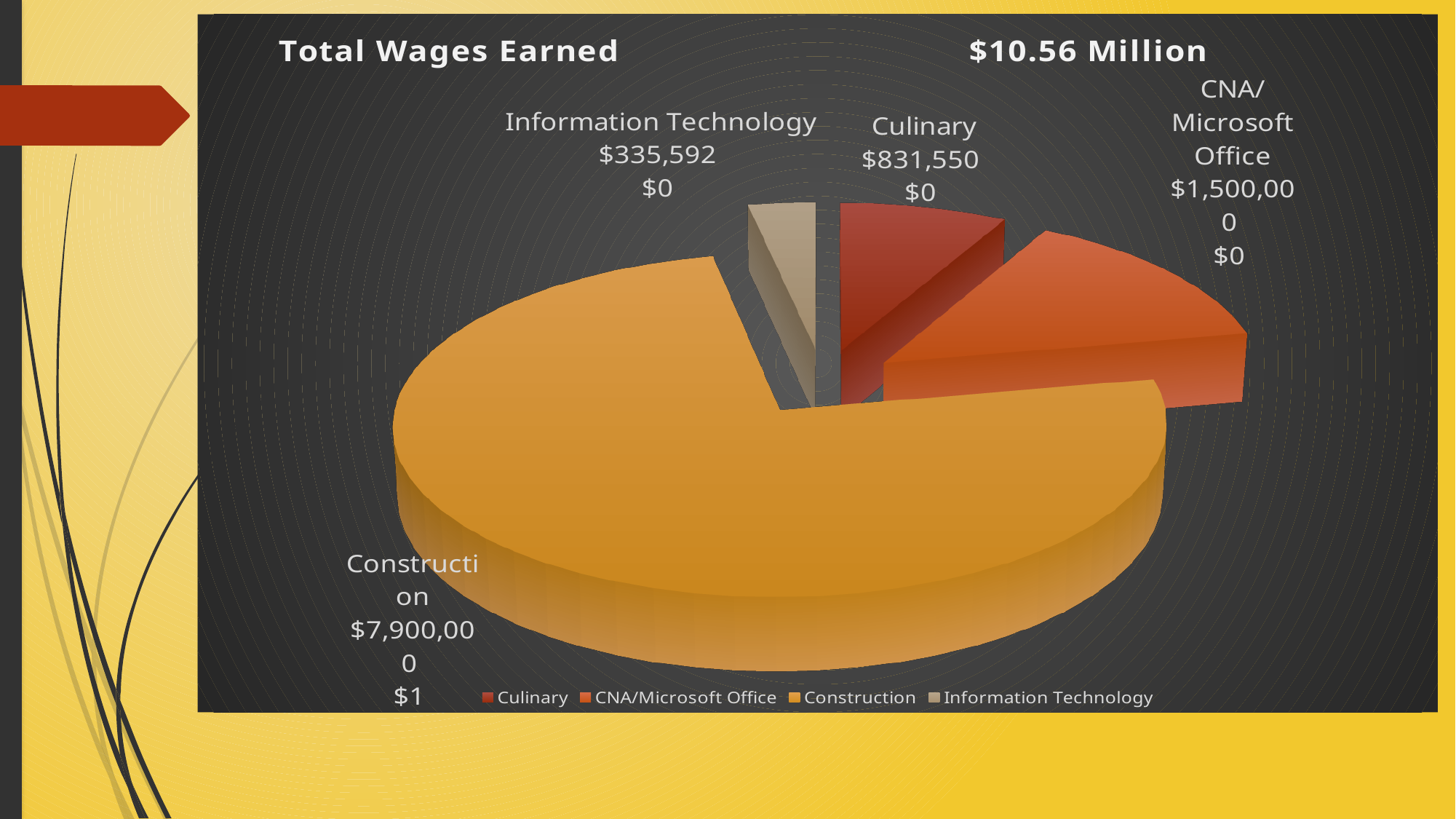
What is the value shown for Information Technology? $335,592 Which category has the smallest slice of the pie? Information Technology What is the value shown for Culinary? $831,550 What kind of chart is shown on the slide? Pie chart How many entries does the legend list? 4 What is the difference between the Construction value and the CNA/Microsoft Office value? $6,400,000 Which category has the largest slice of the pie? Construction What is the title of the chart? Total Wages Earned $10.56 Million Which is larger, the value for Culinary or the value for CNA/Microsoft Office? CNA/Microsoft Office What is the value shown for Construction? $7,900,000 What is the value shown for CNA/Microsoft Office? $1,500,000 How many categories does the pie chart show? 4